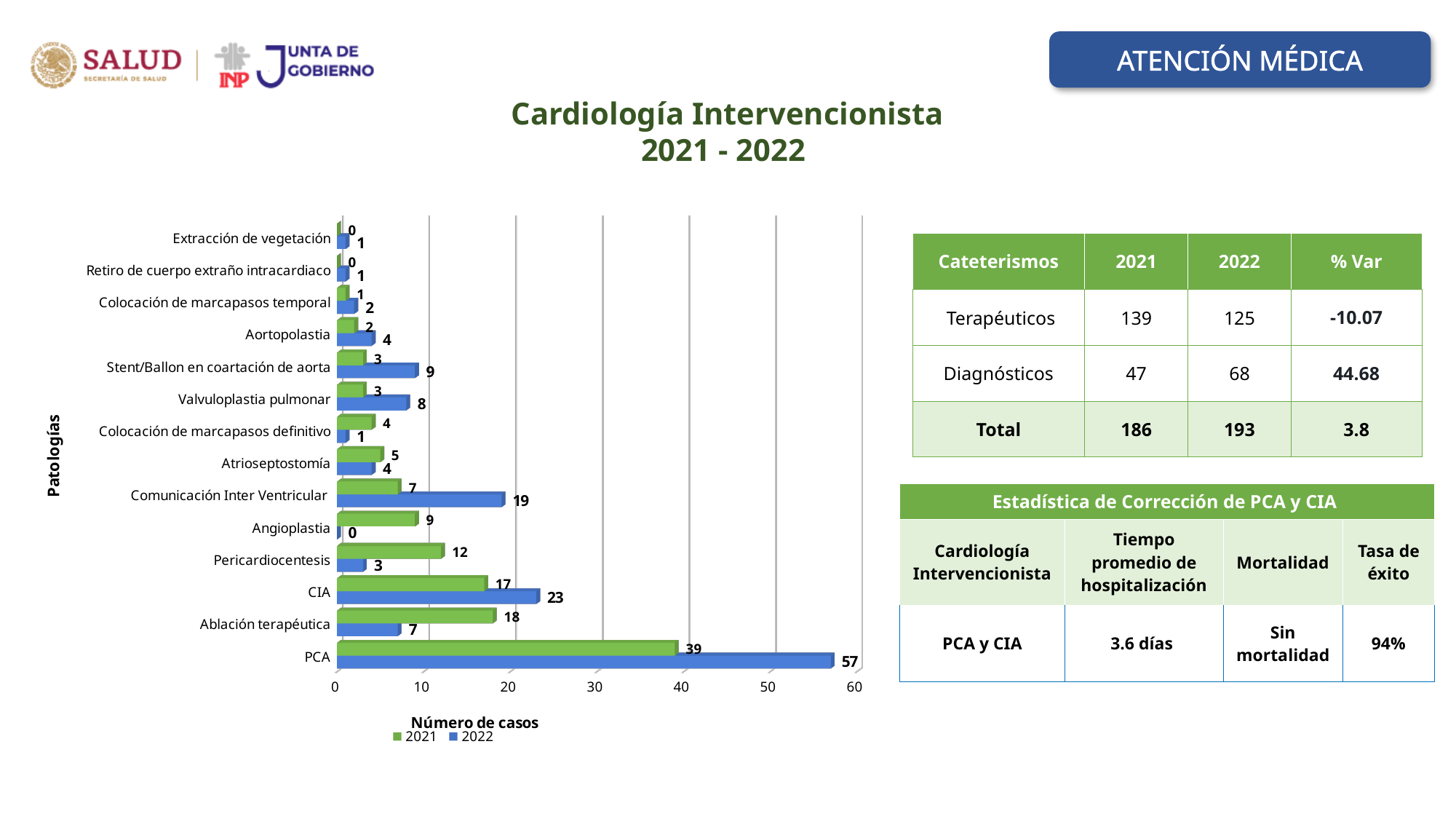
What is the difference between the 2022 and 2021 values for CIA? 6 What is the 2022 value for PCA? 57 Is the 2022 value for PCA greater or less than 50? greater Which is larger for Ablación terapéutica, the 2021 value or the 2022 value? 2021 What is the 2022 value for Comunicación Inter Ventricular? 19 How many series does the legend list? 2 What kind of chart is shown? bar chart Which category has the lowest 2022 value? Angioplastia Which category has the highest 2021 value? PCA What is the label of the x axis? Número de casos What is the 2021 value for Pericardiocentesis? 12 How many categories (pathologies) are shown on the chart? 14